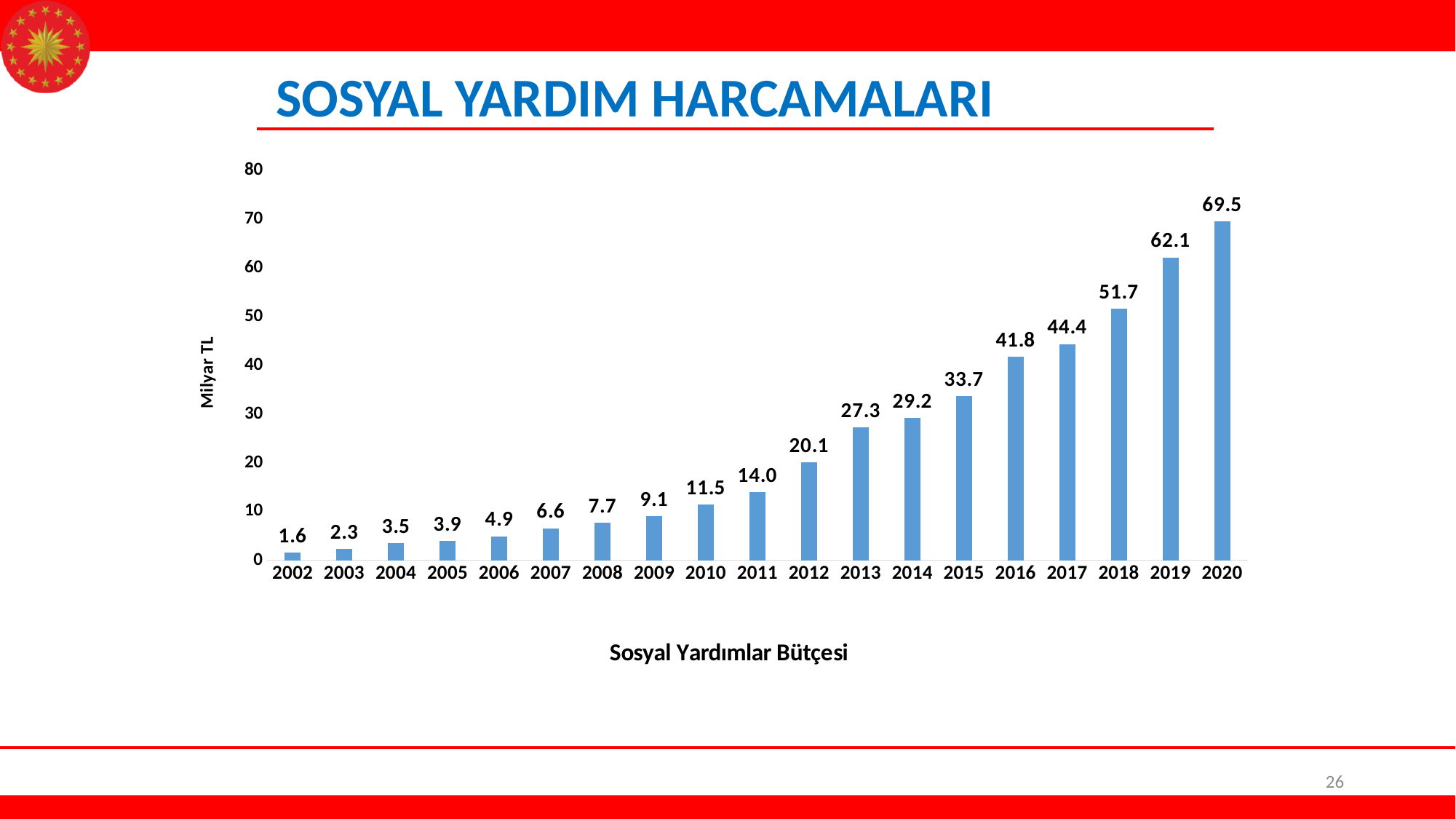
Which is larger, the value for 2014 or the value for 2013? 2014 What is the difference between the values for 2016 and 2015? 8.1 Which year has the lowest value? 2002 Do the values rise or fall from 2002 to 2020? rise What is the difference between the values for 2020 and 2019? 7.4 Which year has the highest value? 2020 What is the value for 2002? 1.6 What is the value for 2012? 20.1 How many years are shown on the x axis? 19 What is the value for 2018? 51.7 Is the value for 2017 greater or less than 40? greater What kind of chart is shown on the slide? bar chart